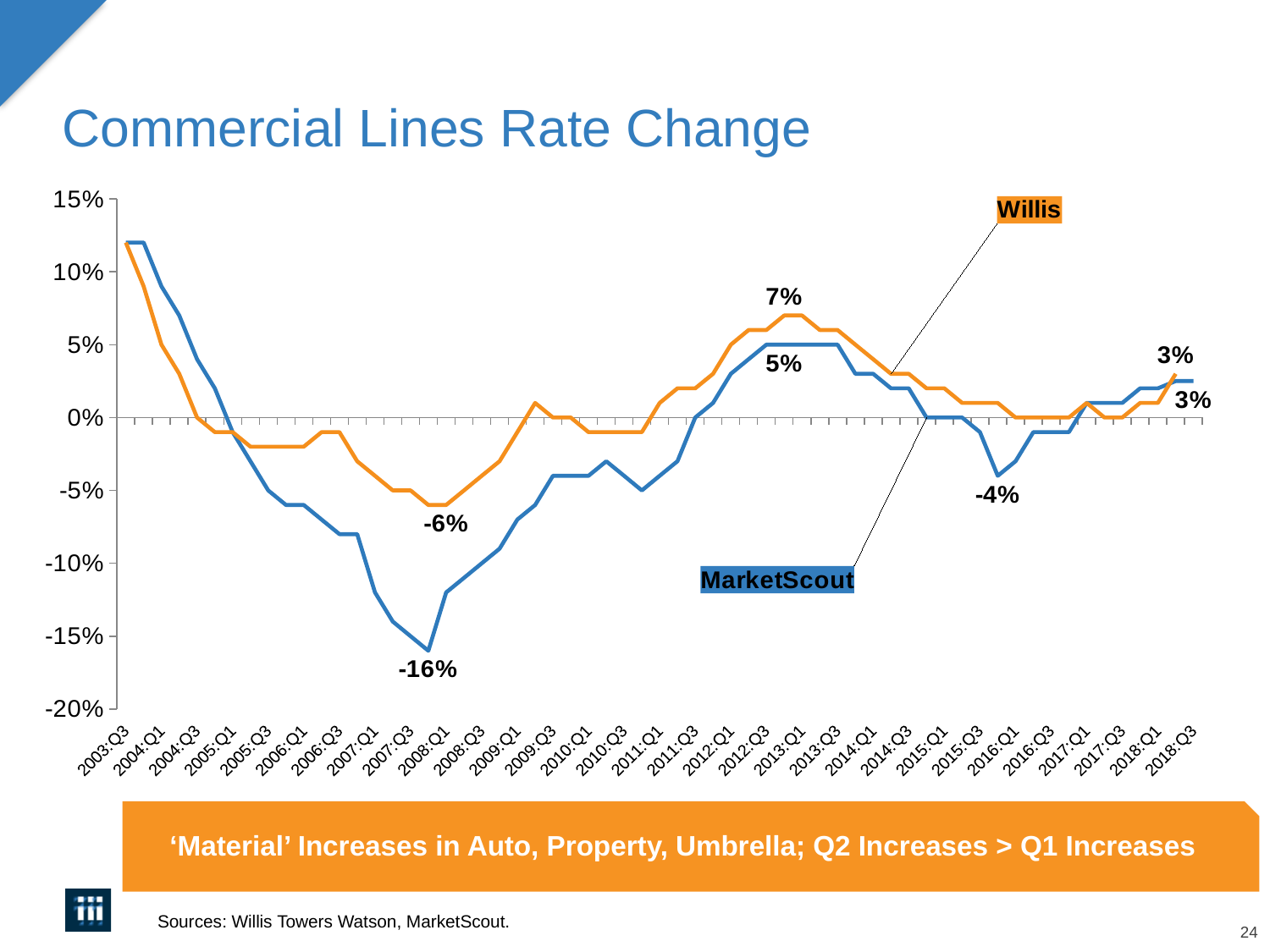
What kind of chart is shown on the slide? Line chart What is the highest labeled value for the MarketScout series? 5% What is the labeled value for Willis at the end of the series (2018:Q3)? 3% What is the difference between the Willis low of -6% and the MarketScout low of -16%? 10 percentage points Is the MarketScout value at 2003:Q3 greater or less than 10%? greater How many series are plotted on the chart? 2 What is the highest labeled value for the Willis series? 7% Which series is drawn in orange? Willis What is the lowest labeled value for the Willis series? -6% What is the lowest labeled value for the MarketScout series? -16% Which series reached a lower minimum, Willis or MarketScout? MarketScout What is the difference between the Willis peak of 7% and the MarketScout peak of 5%? 2 percentage points